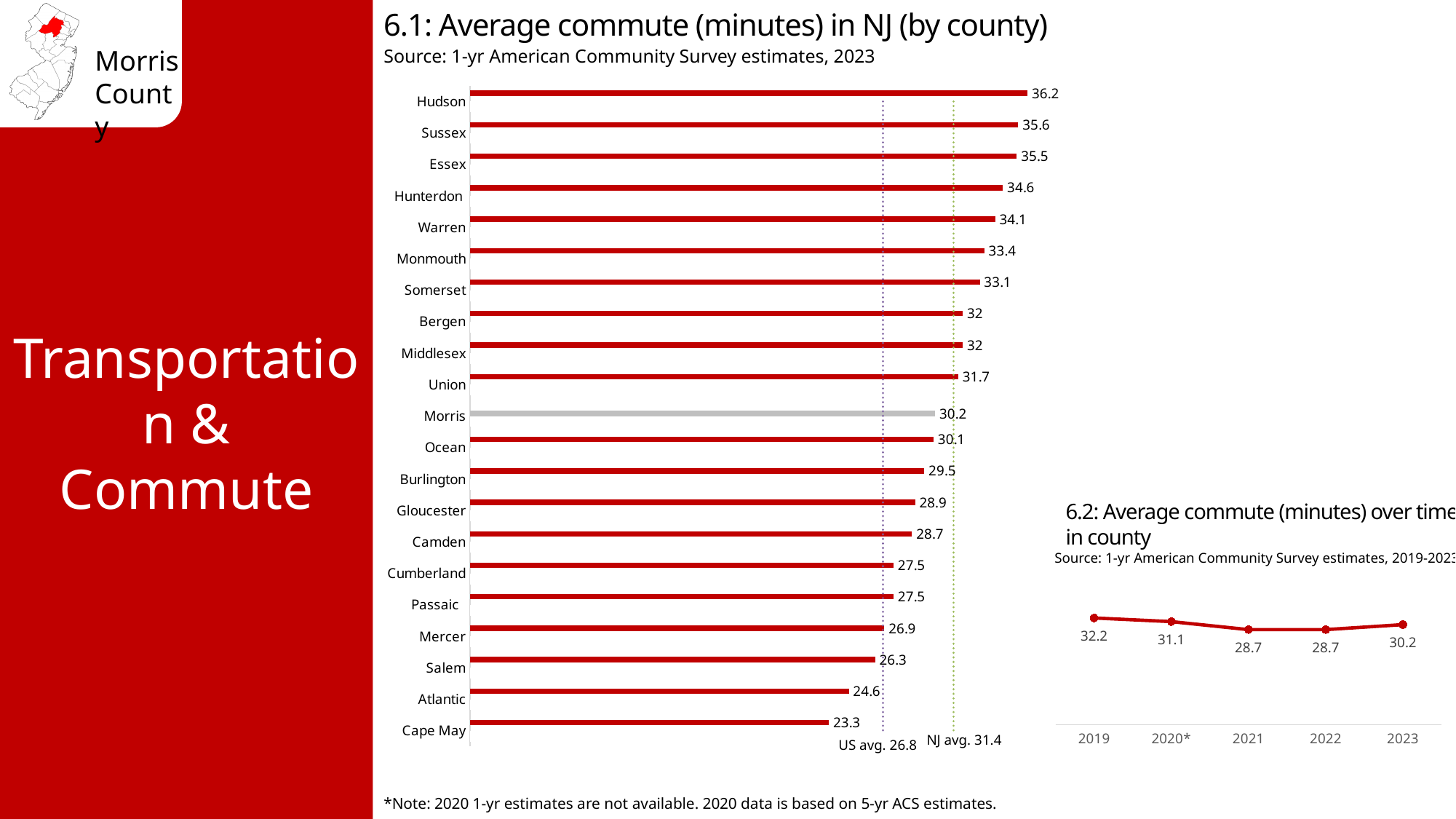
In chart 6.1 (Average commute in NJ by county), which county has the lowest average commute? Cape May In chart 6.2 (Average commute over time in county), how many years are plotted? 5 In chart 6.1 (Average commute in NJ by county), what is the average commute for Atlantic? 24.6 In chart 6.1 (Average commute in NJ by county), which county has the highest average commute? Hudson In chart 6.2 (Average commute over time in county), what is the difference between the 2019 and 2023 values? 2 In chart 6.2 (Average commute over time in county), what was the average commute in 2019? 32.2 In chart 6.1 (Average commute in NJ by county), what is the difference between Hudson's and Cape May's average commute? 12.9 In chart 6.1 (Average commute in NJ by county), which has a longer average commute, Sussex or Warren? Sussex What kind of chart is chart 6.1 (Average commute in NJ by county)? bar chart In chart 6.1 (Average commute in NJ by county), what is the average commute for Morris? 30.2 In chart 6.1 (Average commute in NJ by county), what NJ average value is marked by the dotted line? 31.4 In chart 6.1 (Average commute in NJ by county), how many counties are shown? 21